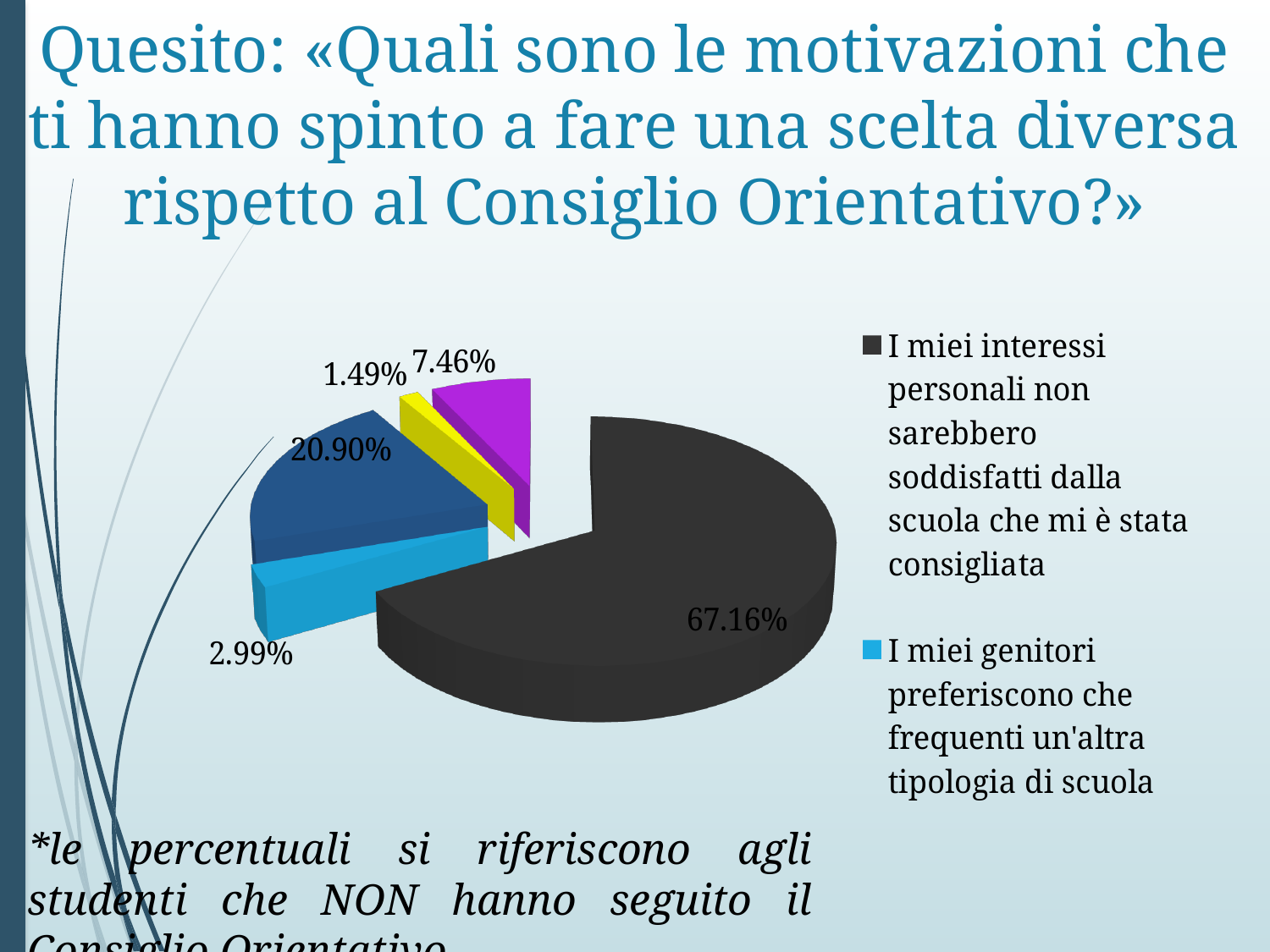
What percentage is shown for 'I miei interessi personali non sarebbero soddisfatti dalla scuola che mi è stata consigliata'? 67.16% What kind of chart is shown on the slide? pie chart What is the difference in percentage points between the 7.46% slice and the 1.49% slice? 5.97 Which is larger, the dark blue slice at 20.90% or the magenta slice at 7.46%? 20.90% Which is larger, the magenta slice at 7.46% or the slice labelled 2.99%? 7.46% What is the value of the largest slice of the pie chart? 67.16% What colour is the largest slice of the pie chart? dark gray What is the difference in percentage points between the 67.16% slice and the 20.90% slice? 46.26 How many slices does the pie chart have? 5 Does the largest slice account for more or less than half of the pie? more What is the combined share of the two smallest slices (1.49% and 2.99%)? 4.48% What is the value of the smallest slice of the pie chart? 1.49%